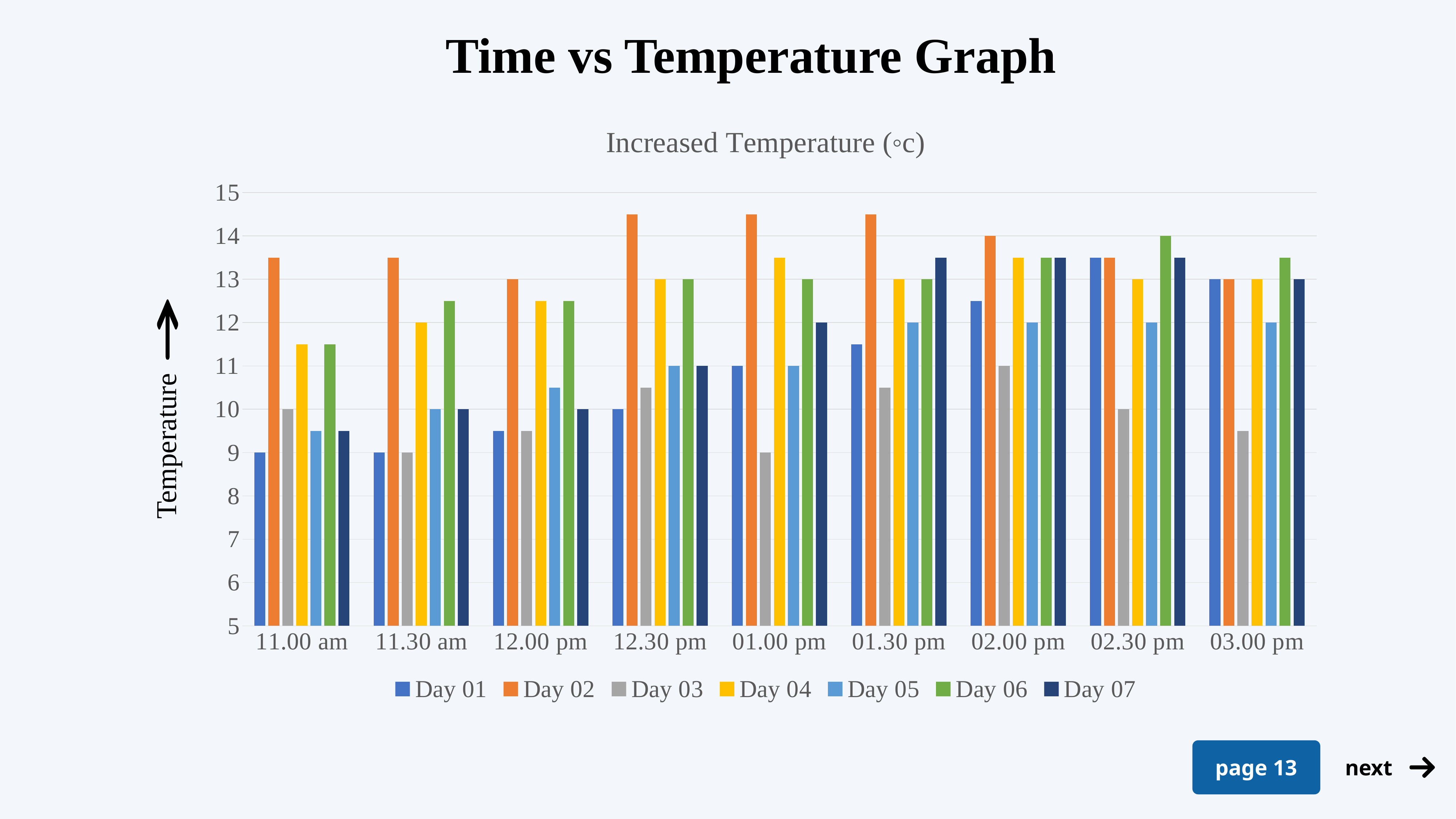
Which is larger at 12.30 pm, the value for Day 02 or the value for Day 03? Day 02 Which day has the highest value at 11.00 am? Day 02 What is the difference between the value for Day 03 and the value for Day 01 at 11.00 am? 1 How many time categories are shown on the x axis? 9 What kind of chart is shown on the slide? bar chart What is the value for Day 01 at 11.00 am? 9 Which day has the lowest value at 01.00 pm? Day 03 What is the value for Day 06 at 02.30 pm? 14 Is the value for Day 04 at 11.00 am greater or less than 12? less What is the title printed above the chart? Increased Temperature (°c) What is the value for Day 07 at 01.00 pm? 12 How many series does the legend list? 7